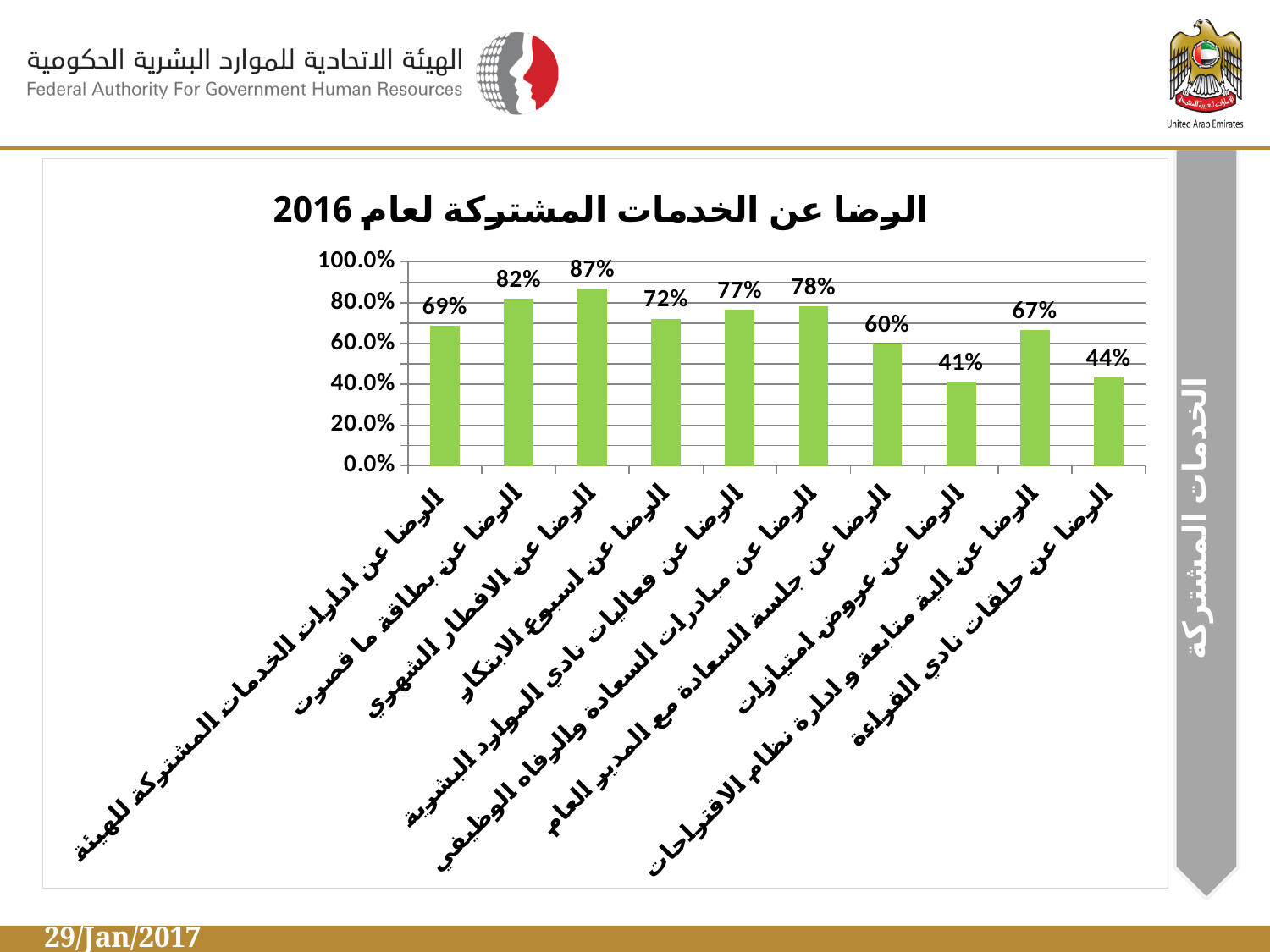
What is the satisfaction value for حلقات نادي القراءة (the reading club sessions)? 44% How many categories (bars) are shown in the chart? 10 What is the difference between the values for مبادرات السعادة والرفاه الوظيفي (78%) and فعاليات نادي الموارد البشرية (77%)? 1% What is the satisfaction value for بطاقة ما قصرت? 82% What is the title of the chart? الرضا عن الخدمات المشتركة لعام 2016 Which category has the highest satisfaction value? الرضا عن الافطار الشهري What is the satisfaction value for عروض امتيازات? 41% Which category has the lowest satisfaction value? الرضا عن عروض امتيازات What is the satisfaction value for الافطار الشهري (the monthly breakfast)? 87% What kind of chart is shown on the slide? Bar chart What is the difference between the highest value (87%) and the lowest value (41%)? 46% Which is larger: the value for اسبوع الابتكار or the value for جلسة السعادة مع المدير العام? اسبوع الابتكار